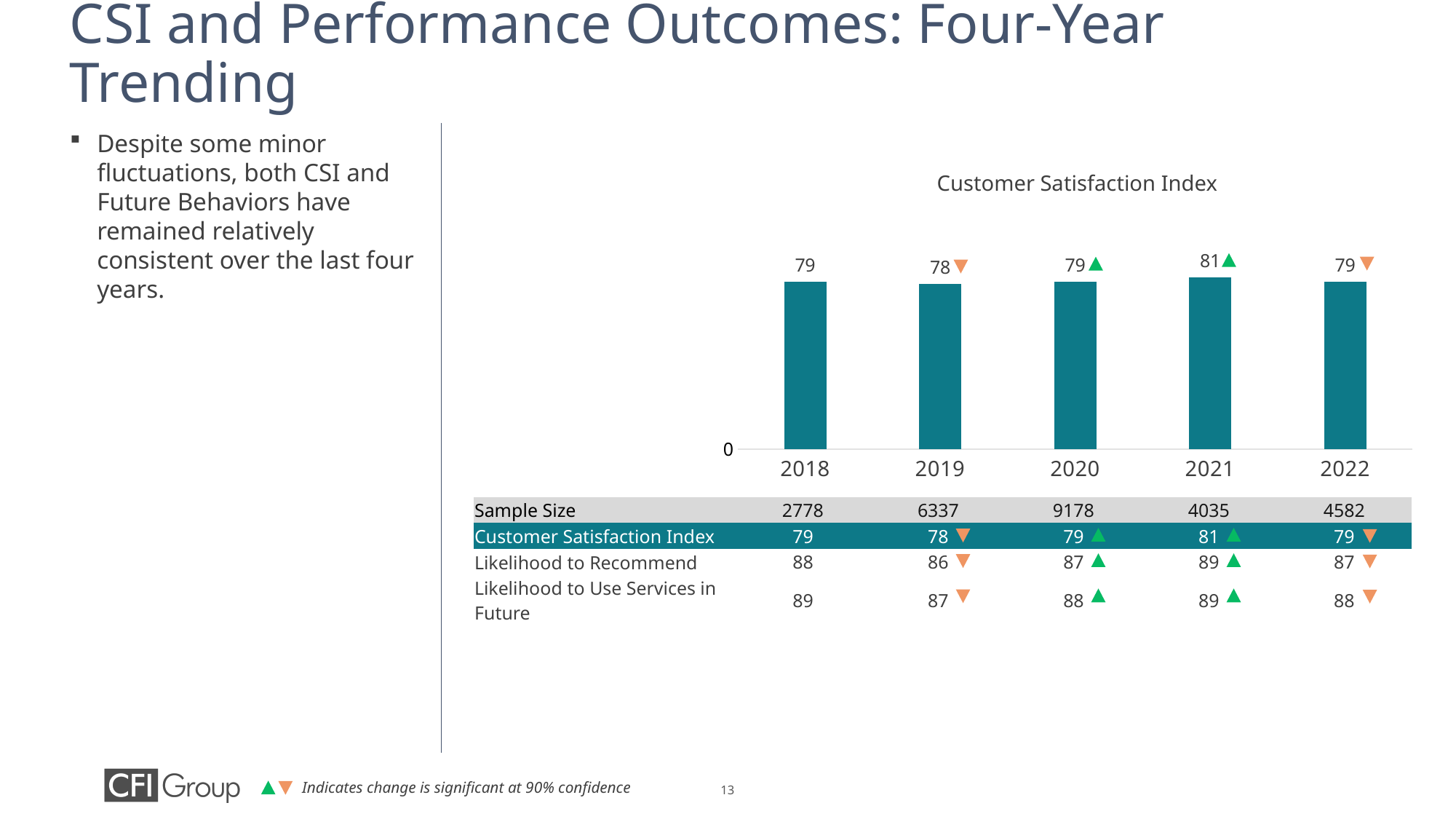
What is the difference between the Customer Satisfaction Index in 2021 and in 2019? 3 Is the Customer Satisfaction Index higher in 2021 or in 2022? 2021 What is the Customer Satisfaction Index value for 2021? 81 What is the title of the chart? Customer Satisfaction Index Did the Customer Satisfaction Index rise or fall from 2021 to 2022? Fall What is the difference between the Customer Satisfaction Index in 2020 and in 2021? 2 Which year has the highest Customer Satisfaction Index? 2021 What is the Customer Satisfaction Index value for 2018? 79 How many years are shown on the Customer Satisfaction Index chart? 5 What is the Customer Satisfaction Index value for 2019? 78 Which year has the lowest Customer Satisfaction Index? 2019 What type of chart is used to show the Customer Satisfaction Index? Bar chart